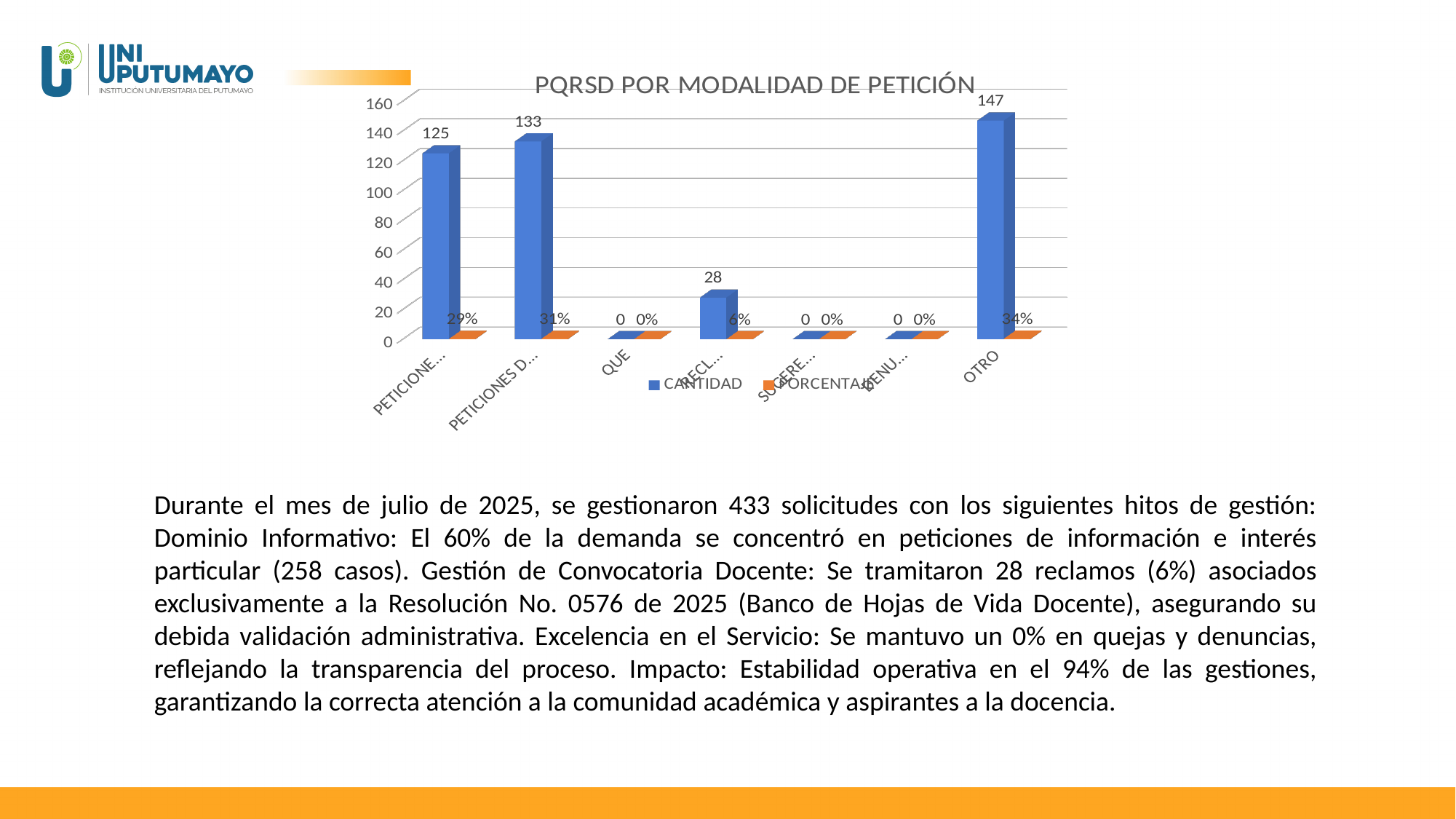
Which category has the highest CANTIDAD value? OTRO Which has the larger CANTIDAD value, the first category from the left or the second category from the left? the second category from the left How many series does the chart's legend list? 2 What is the difference between the CANTIDAD value for OTRO and the CANTIDAD value for the second category from the left? 14 What is the title of the chart? PQRSD POR MODALIDAD DE PETICIÓN What is the CANTIDAD value for the second category from the left? 133 How many categories are shown along the x axis of the chart? 7 What are the two series named in the legend? CANTIDAD and PORCENTAJE What is the CANTIDAD value for OTRO? 147 How many categories have a CANTIDAD value of 0? 3 What kind of chart is shown on the slide? bar chart What is the PORCENTAJE value for OTRO? 34%